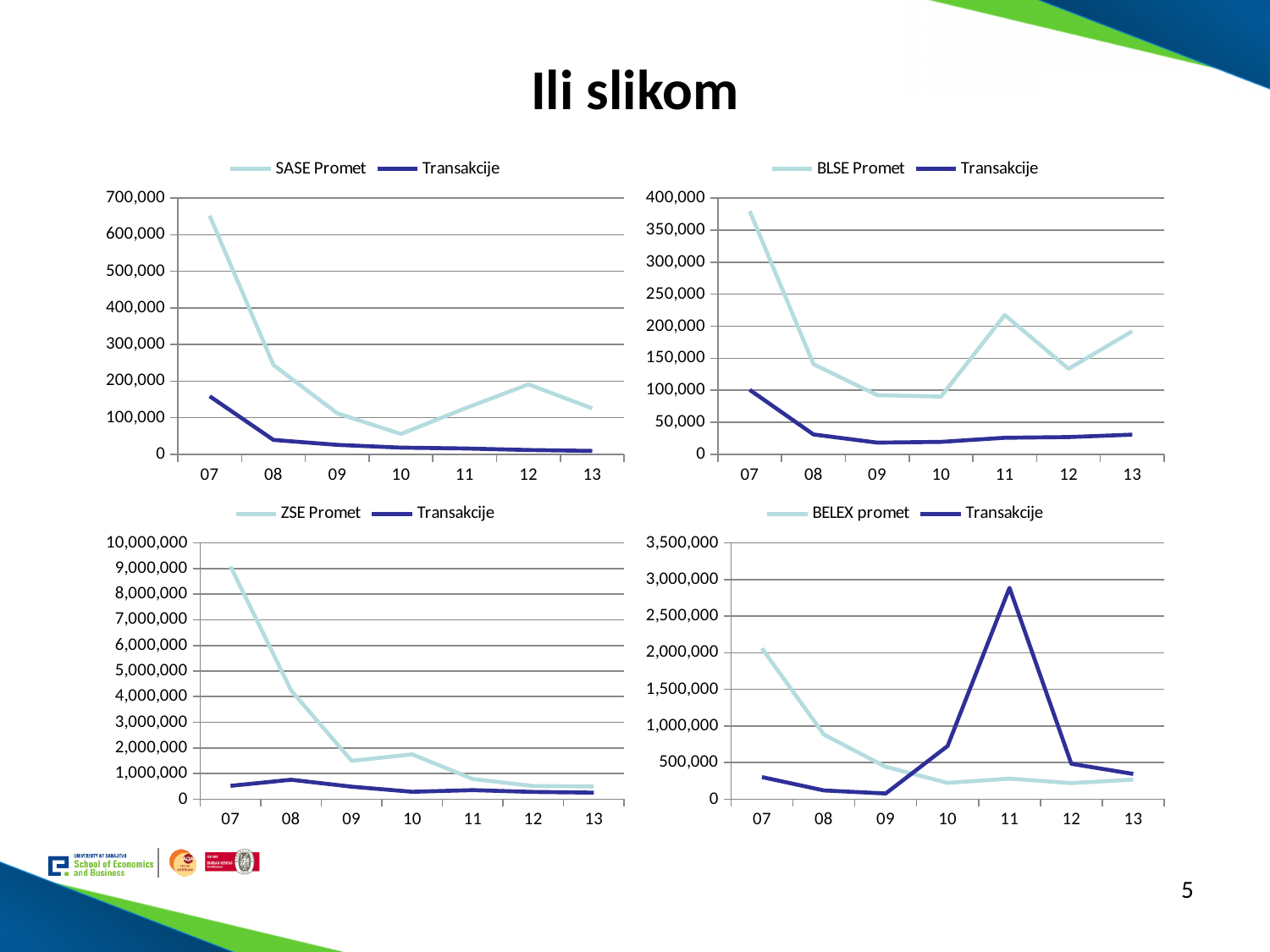
In the top-left chart, is the SASE Promet value for 07 greater or less than 600,000? greater In the top-left chart, in which year is SASE Promet lowest? 10 In the top-right chart, in which year is BLSE Promet highest? 07 In the bottom-left chart, is the ZSE Promet value for 07 greater or less than 8,000,000? greater In the top-left chart, in which year is SASE Promet highest? 07 In the bottom-left chart, in which year is Transakcije highest? 08 What kind of chart is the top-left chart with the SASE Promet legend? line chart How many years are plotted along the x axis of the bottom-left chart (ZSE Promet)? 7 In the bottom-right chart, which series has the larger value in 11, BELEX promet or Transakcije? Transakcije How many series does the legend of the top-right chart (BLSE Promet) list? 2 In the top-right chart, is the BLSE Promet value for 11 greater or less than 200,000? greater